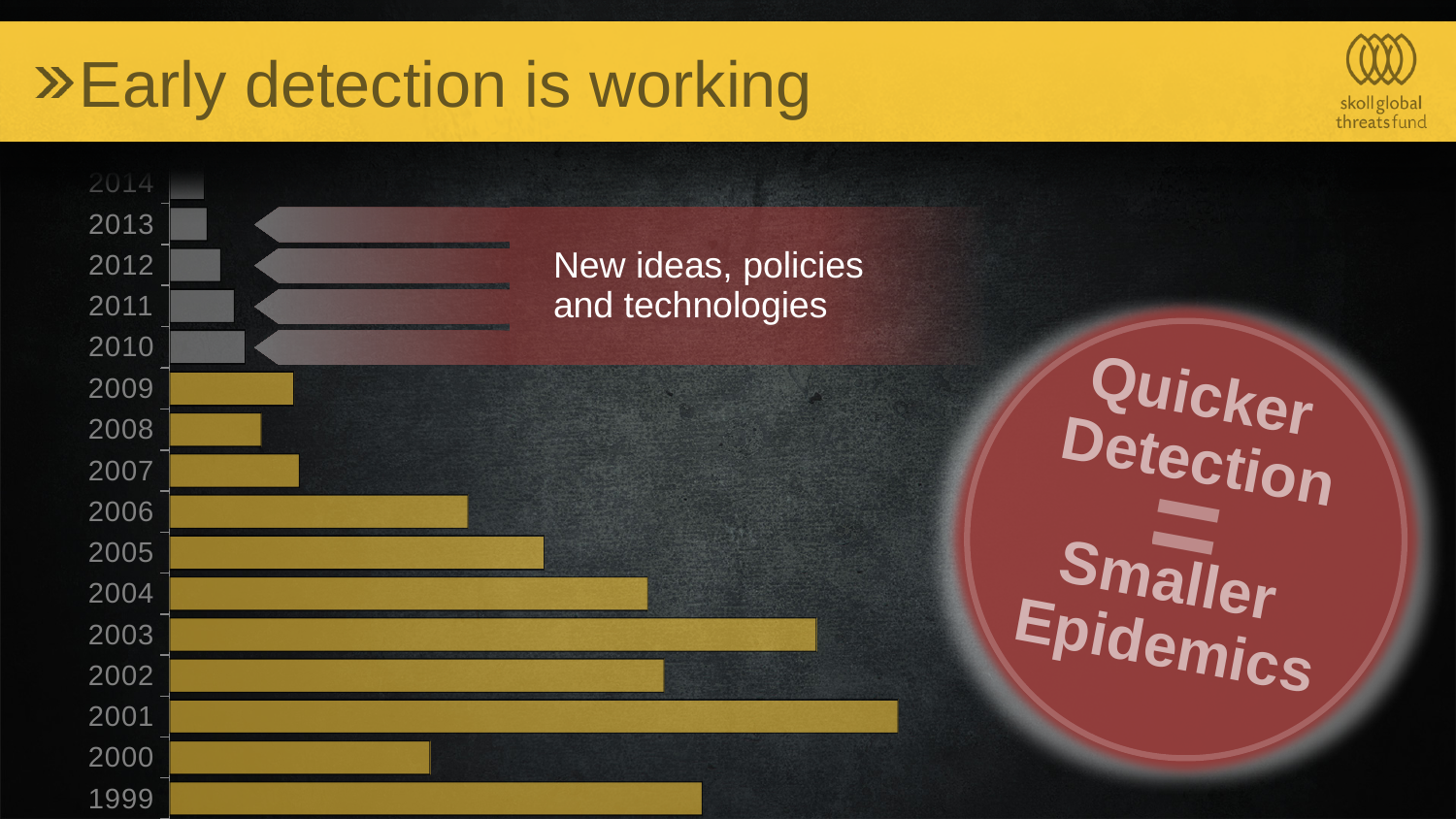
Which year has the shortest bar on the chart? 2014 Do the bar lengths generally rise or fall going from 1999 to 2014? Fall Which bar is longer, 2005 or 2006? 2005 What kind of chart is shown on the slide? Bar chart How many years are listed on the chart's axis? 16 Which year has the longest bar on the chart? 2001 What is the title of the slide containing the chart? Early detection is working Among the yellow bars, which year has the shortest bar? 2008 What colour are the bars for the years 2010 through 2014? Grey Which bar is longer, 1999 or 2000? 1999 Which bar is longer, 2010 or 2013? 2010